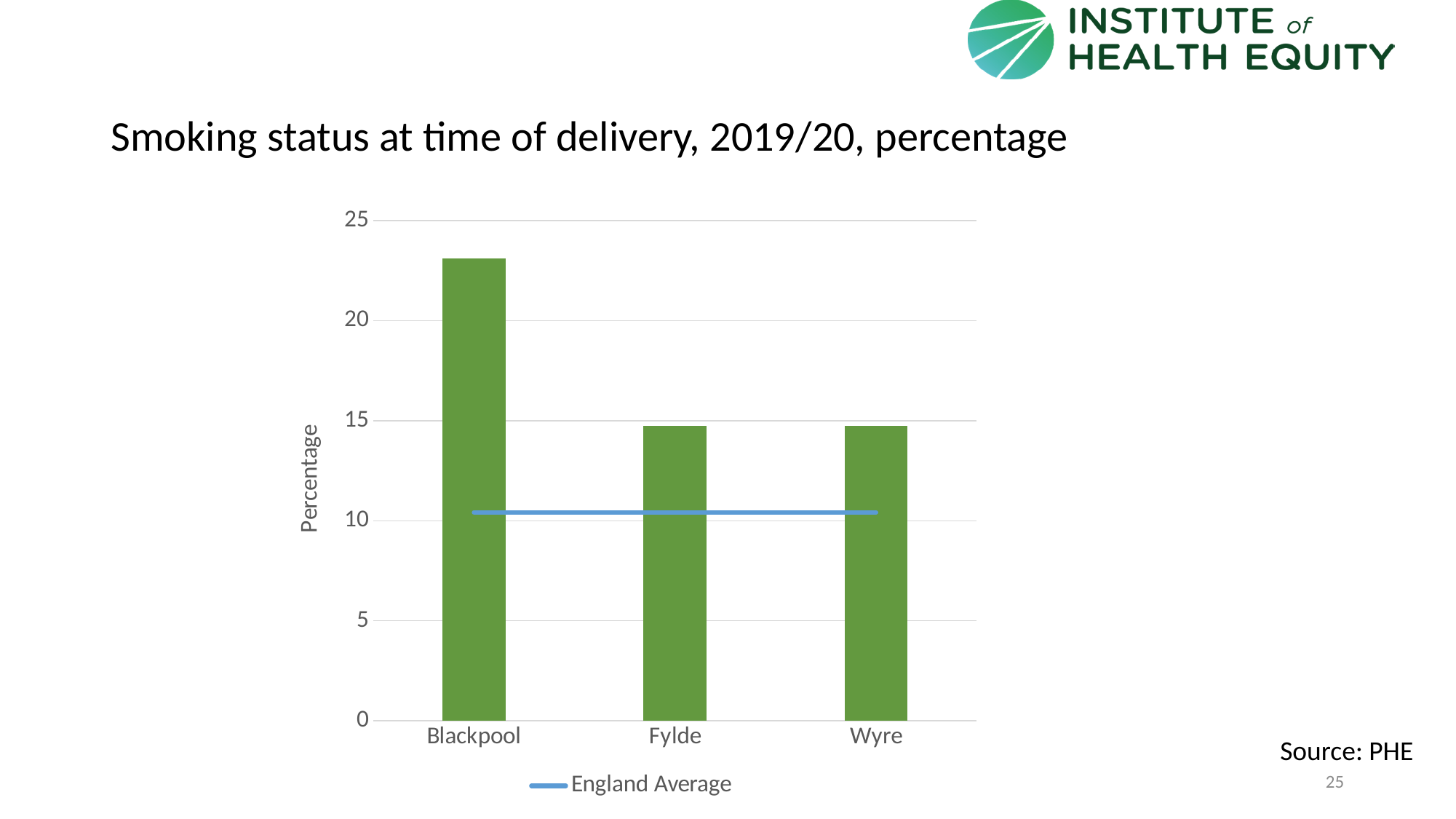
What is the title of the chart? Smoking status at time of delivery, 2019/20, percentage Is the value for Fylde greater or less than 10? greater Which is larger, the value for Wyre or the England Average? Wyre Is the value for Wyre greater or less than 20? less Is the England Average line greater or less than 15? less Which is larger, the value for Blackpool or the value for Fylde? Blackpool What kind of chart is shown on the slide? bar chart What is the label on the vertical axis? Percentage What entry does the legend list? England Average How many areas are plotted as bars on the chart? 3 Which area has the highest smoking status at time of delivery? Blackpool